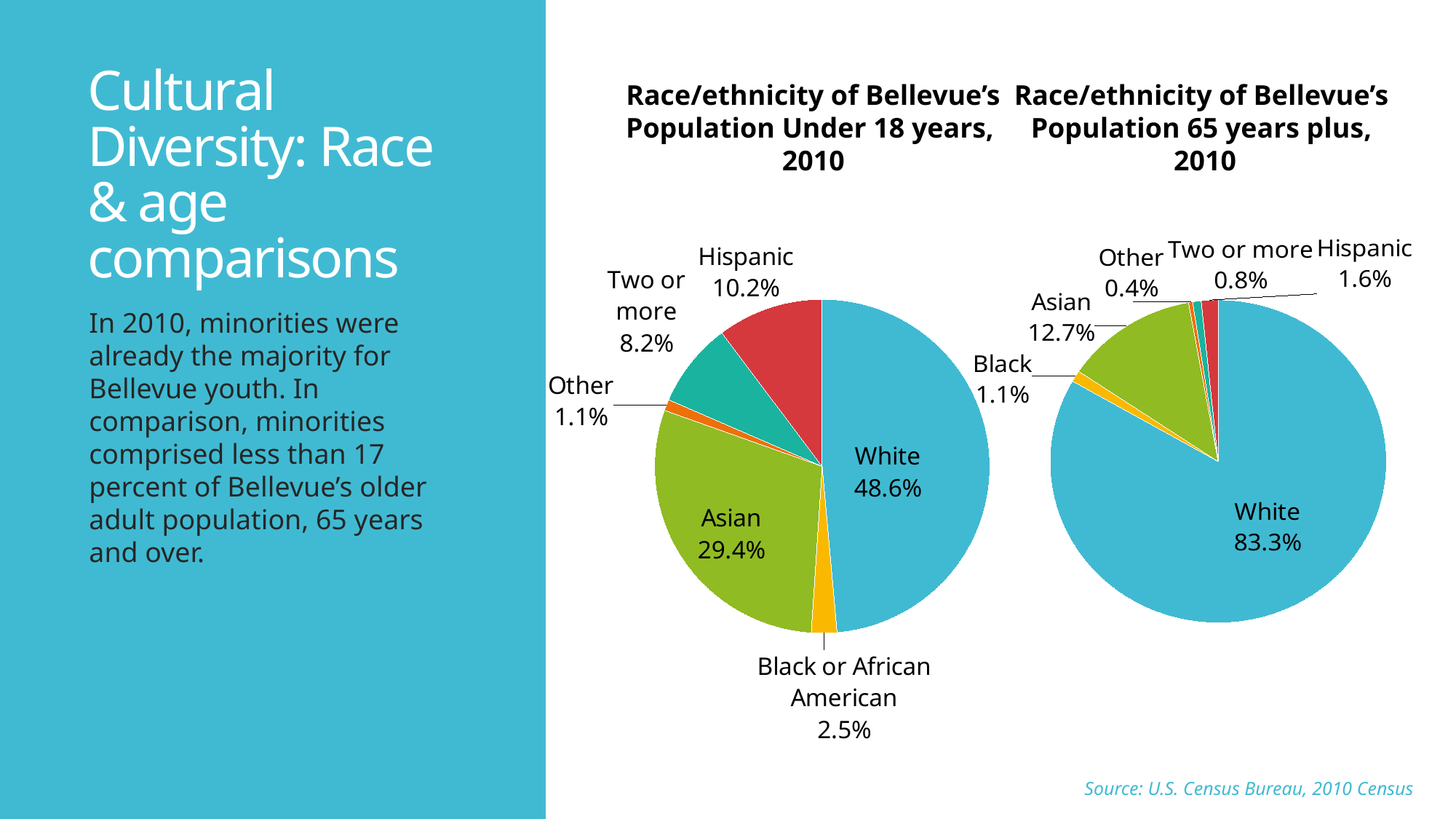
What is the difference between the White share in the 65 years plus chart and the White share in the Under 18 years chart? 34.7% How many categories are shown in the 'Race/ethnicity of Bellevue's Population Under 18 years, 2010' chart? 6 In the 'Race/ethnicity of Bellevue's Population 65 years plus, 2010' chart, what share is Asian? 12.7% In the 'Race/ethnicity of Bellevue's Population Under 18 years, 2010' chart, what share is Black or African American? 2.5% In the 'Race/ethnicity of Bellevue's Population Under 18 years, 2010' chart, which is larger: Hispanic or Two or more? Hispanic What kind of chart is the 'Race/ethnicity of Bellevue's Population 65 years plus, 2010' chart? Pie chart What source is cited for the charts on the slide? U.S. Census Bureau, 2010 Census In the 'Race/ethnicity of Bellevue's Population 65 years plus, 2010' chart, which category has the smallest slice? Other In the 'Race/ethnicity of Bellevue's Population Under 18 years, 2010' chart, which category has the largest slice? White In the 'Race/ethnicity of Bellevue's Population 65 years plus, 2010' chart, what share is White? 83.3% In the 'Race/ethnicity of Bellevue's Population Under 18 years, 2010' chart, what share is Hispanic? 10.2% In the 'Race/ethnicity of Bellevue's Population Under 18 years, 2010' chart, what share is Asian? 29.4%